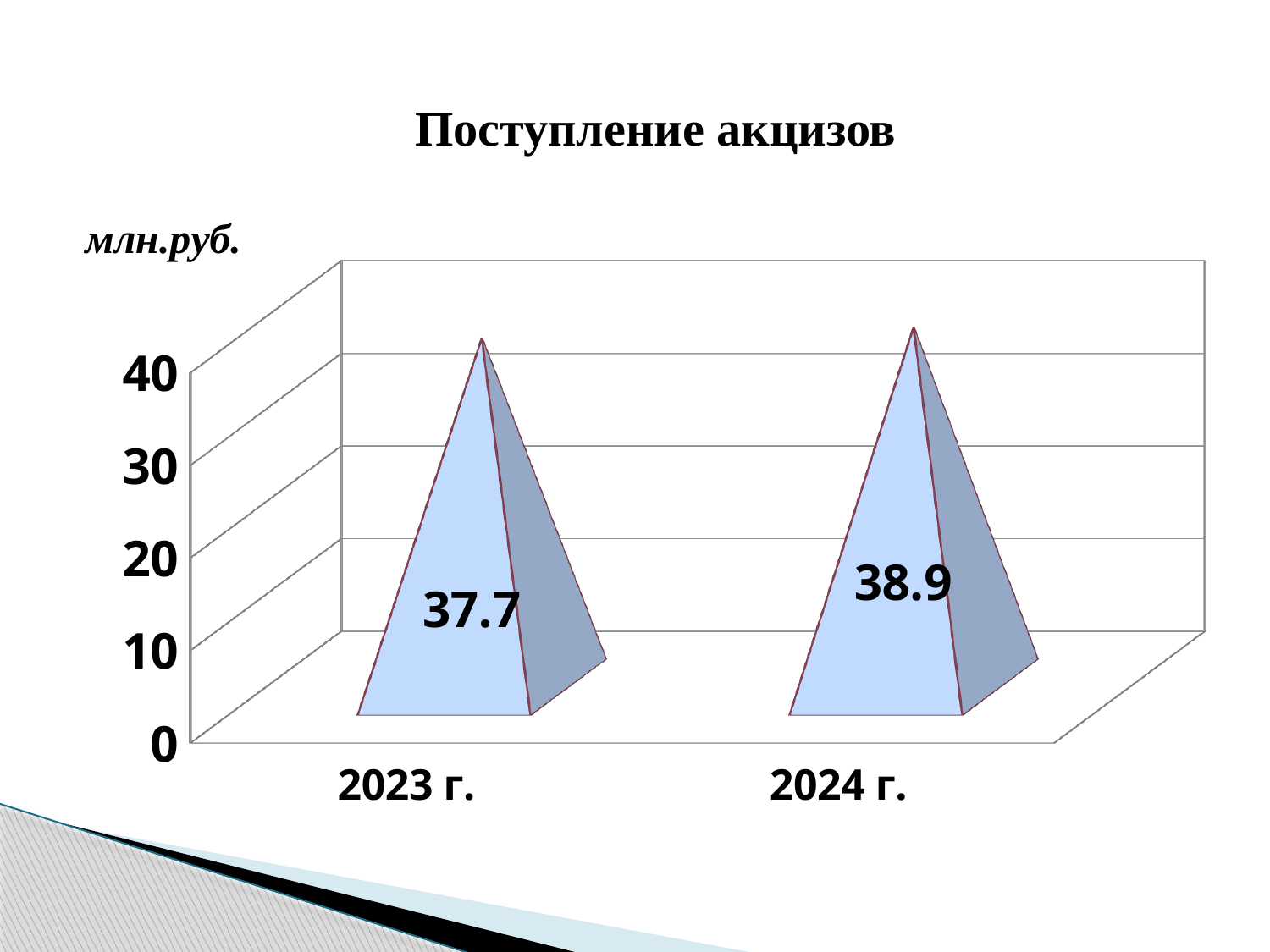
What is the title of the chart? Поступление акцизов What is the difference between the values for 2024 г. and 2023 г.? 1.2 Do the values rise or fall from 2023 г. to 2024 г.? Rise Is the value for 2024 г. larger than the value for 2023 г.? Yes How many categories are shown on the x axis? 2 Is the value for 2023 г. greater or less than 30? greater Is the value for 2024 г. greater or less than 40? less What is the value for 2023 г.? 37.7 What kind of chart is shown on the slide? Bar chart Which year has the lower value? 2023 г. Which year has the higher value? 2024 г. What is the value for 2024 г.? 38.9